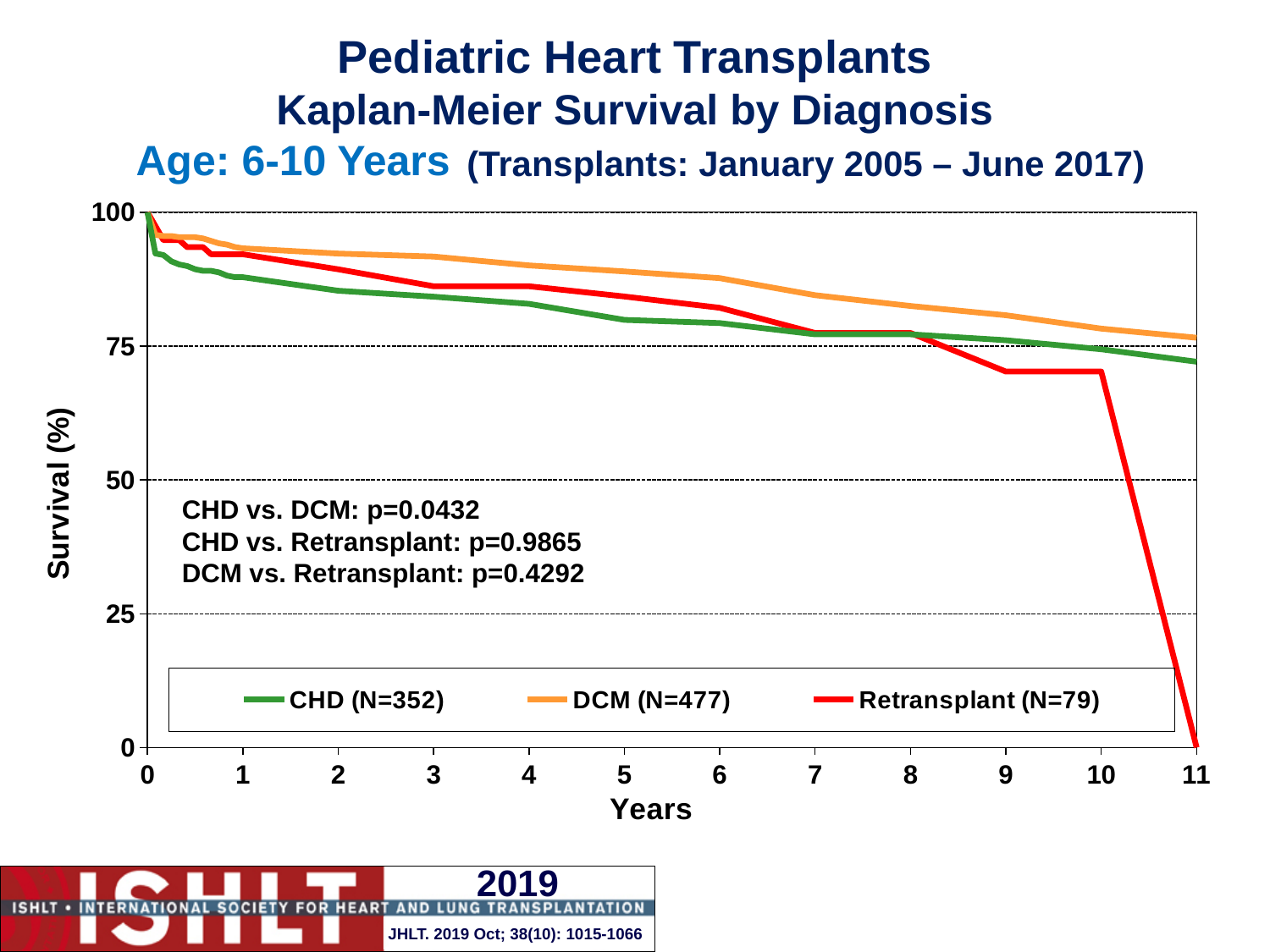
Is the survival for Retransplant at 10 years greater or less than 75? less Does survival for the DCM series rise or fall as years increase? fall How many series does the legend list? 3 What p-value is shown for CHD vs. DCM? p=0.0432 Is the survival for CHD at 11 years greater or less than 75? less Is the survival for CHD at 3 years greater or less than 75? greater At 10 years, which series has higher survival, CHD or Retransplant? CHD What kind of chart is shown on the slide? line chart Which series has the lowest survival at 11 years? Retransplant (N=79) At 5 years, which series has higher survival, CHD or DCM? DCM Which series has the highest survival at 5 years? DCM (N=477)